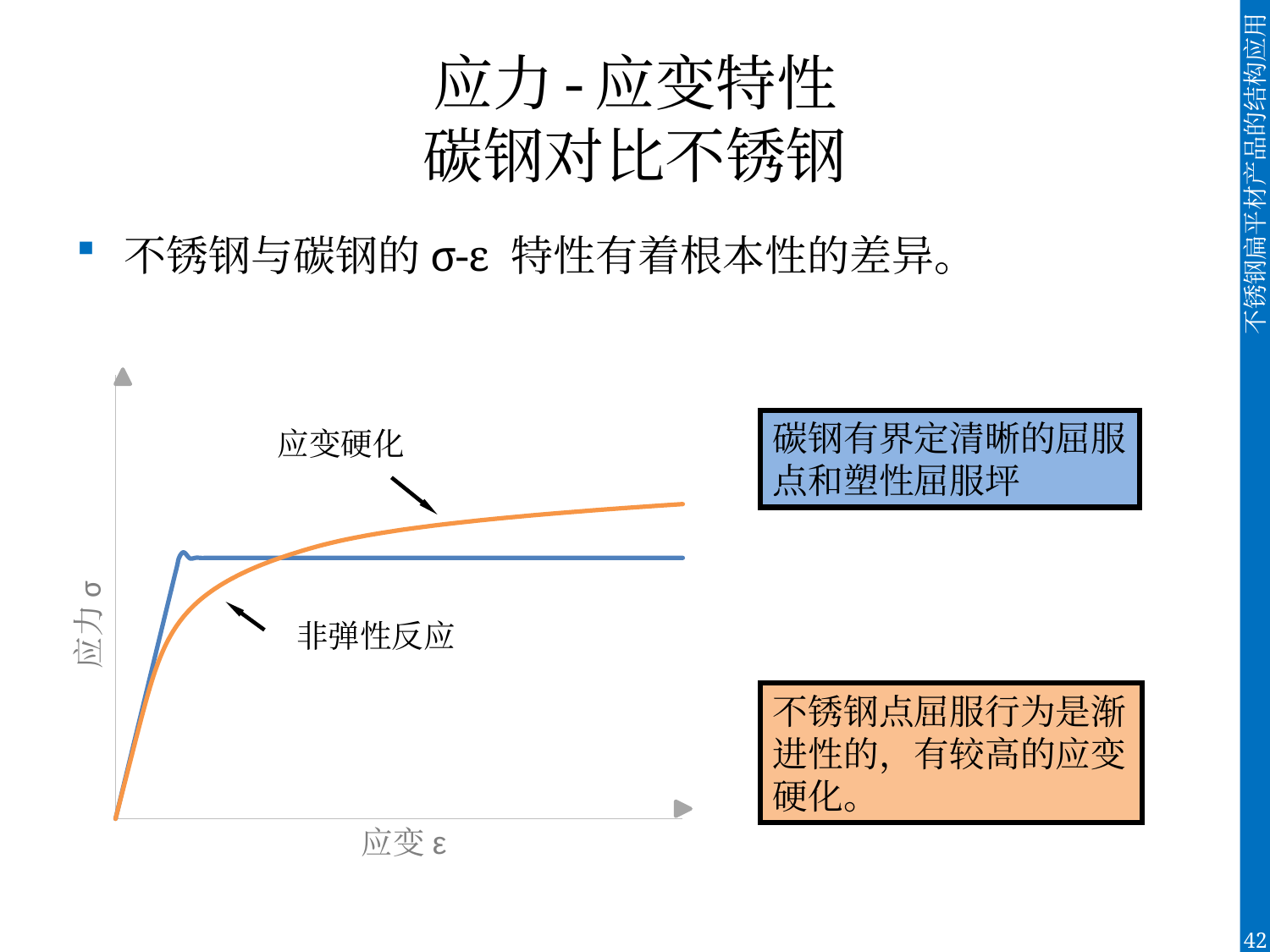
How many curves are plotted on the stress-strain chart? 2 At the right end of the chart, which curve is higher, the orange one or the blue one? orange Which curve shows a sharp peak followed by a flat plateau, the blue one or the orange one? blue Does the orange curve rise or fall as strain increases along the x axis? rises What is the label on the x axis of the chart? 应变 ε Which curve does the arrow labelled 应变硬化 point to, the blue one or the orange one? orange What kind of chart is shown on the slide? line chart After its initial peak, does the blue curve rise, fall, or stay level as strain increases? stays level Which curve keeps increasing gradually without a plateau, the blue one or the orange one? orange